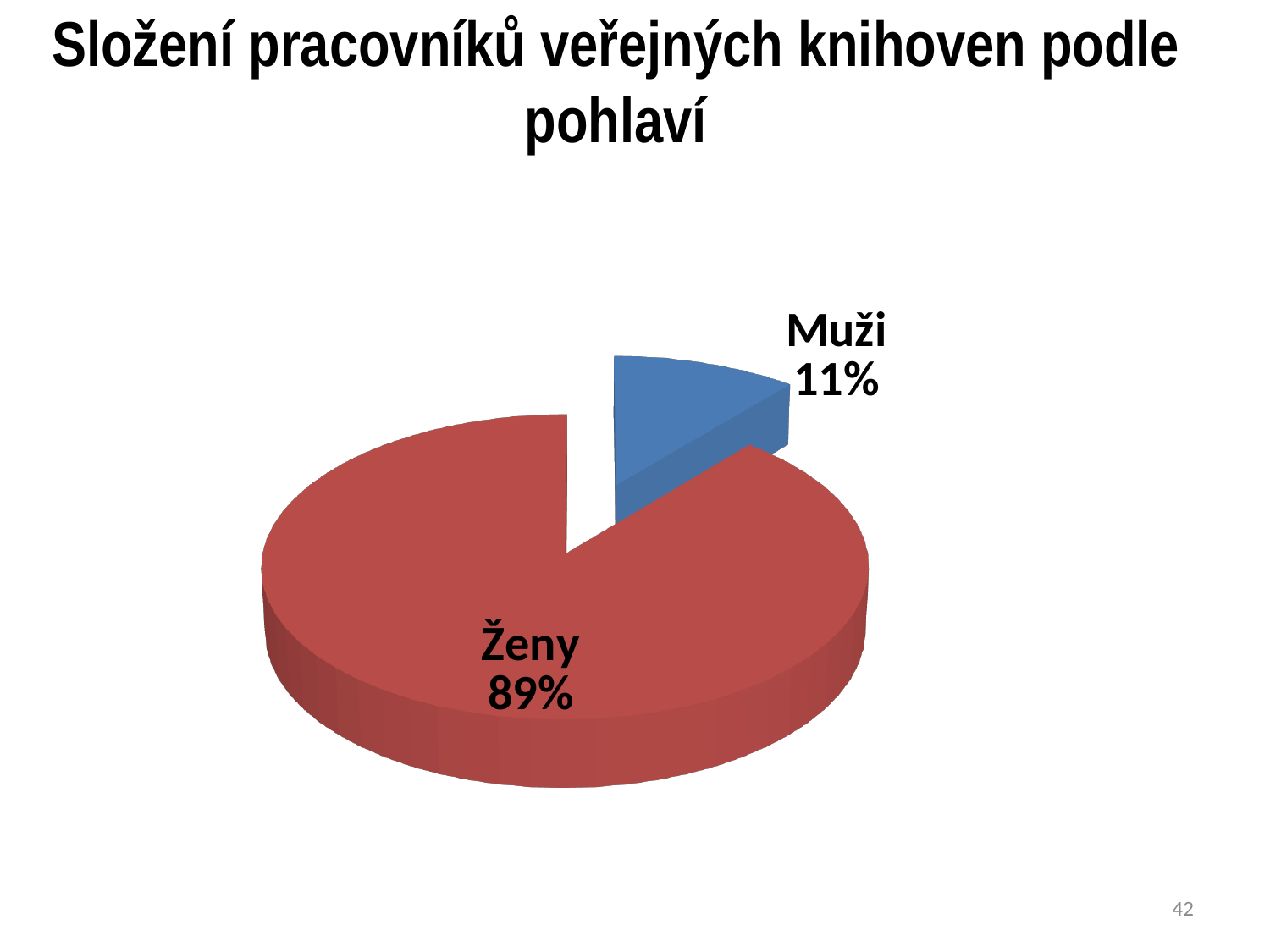
What is the difference in percentage points between the Ženy and Muži slices? 78 How many categories are shown in the pie chart? 2 What share of the pie does Ženy represent? 89% Which category has the largest slice of the pie? Ženy What colour is the Muži slice? Blue What is the title of the chart on the slide? Složení pracovníků veřejných knihoven podle pohlaví Which slice is larger, Muži or Ženy? Ženy What kind of chart is shown on the slide? Pie chart Which category has the smallest slice of the pie? Muži What share of the pie does Muži represent? 11%